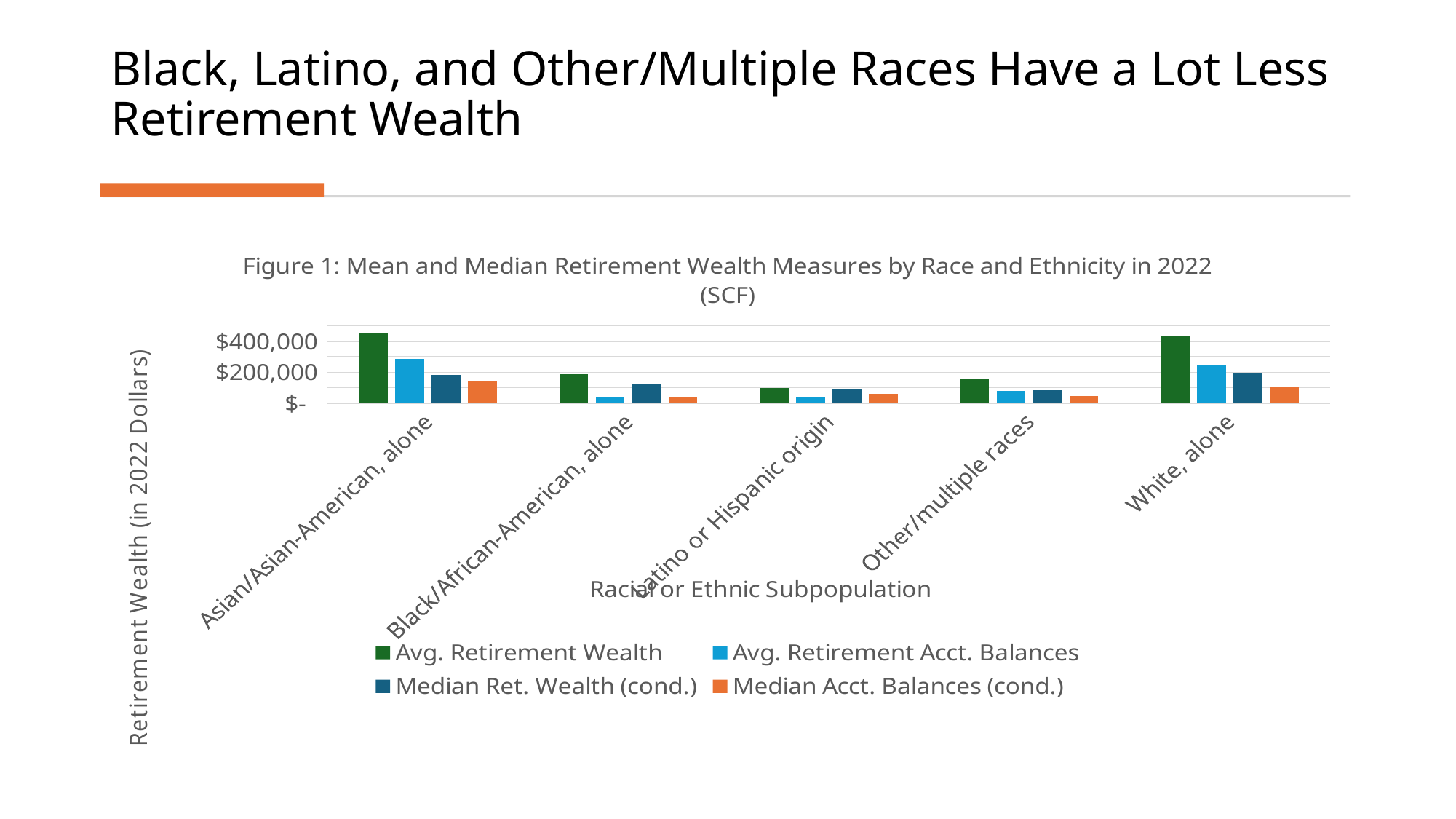
What is the title of the chart? Figure 1: Mean and Median Retirement Wealth Measures by Race and Ethnicity in 2022 (SCF) Is the Avg. Retirement Wealth value for Asian/Asian-American, alone greater or less than $400,000? greater Which series is shown in orange in the legend? Median Acct. Balances (cond.) How many series does the legend list? 4 Is the Avg. Retirement Wealth value for White, alone greater or less than $400,000? greater How many racial or ethnic subpopulations are shown on the x axis? 5 What kind of chart is shown on the slide? Bar chart Which is larger: Avg. Retirement Wealth for Black/African-American, alone or for Latino or Hispanic origin? Black/African-American, alone Which subpopulation has the highest Avg. Retirement Acct. Balances? Asian/Asian-American, alone Is the Avg. Retirement Acct. Balances value for Asian/Asian-American, alone greater or less than $200,000? greater Which subpopulation has the lowest Avg. Retirement Wealth? Latino or Hispanic origin